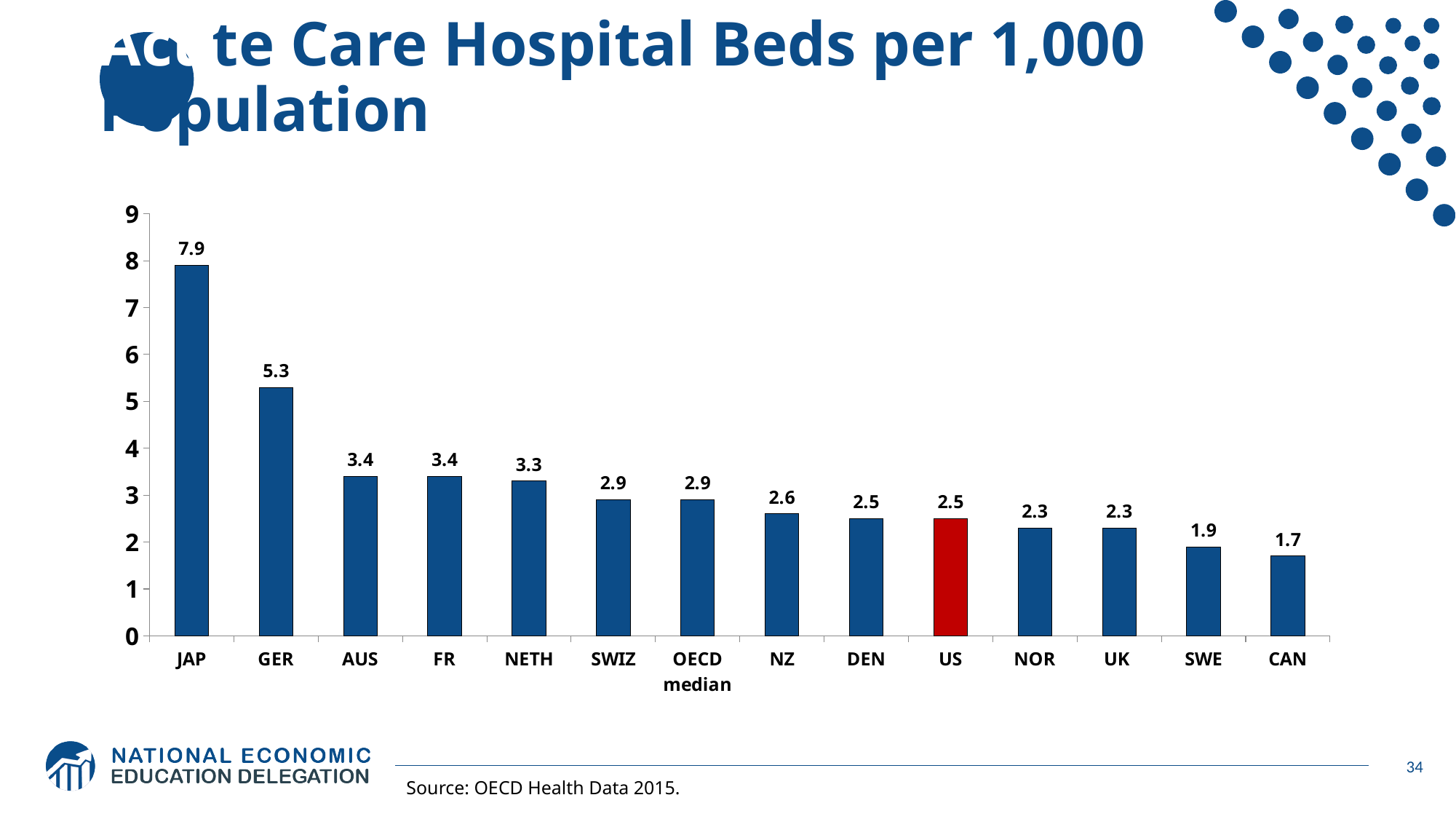
How many categories are shown on the x axis? 14 Which category has the lowest value? CAN What is the difference between the values for JAP and GER? 2.6 Which category has the highest value? JAP What kind of chart is shown on the slide? bar chart What is the value for the US? 2.5 What is the value for the OECD median? 2.9 What is the value for JAP? 7.9 What is the difference between the values for the OECD median and the US? 0.4 Which is larger, the value for NETH or the value for SWE? NETH Which bar is coloured red rather than blue? US Is the value for GER greater or less than 5? greater